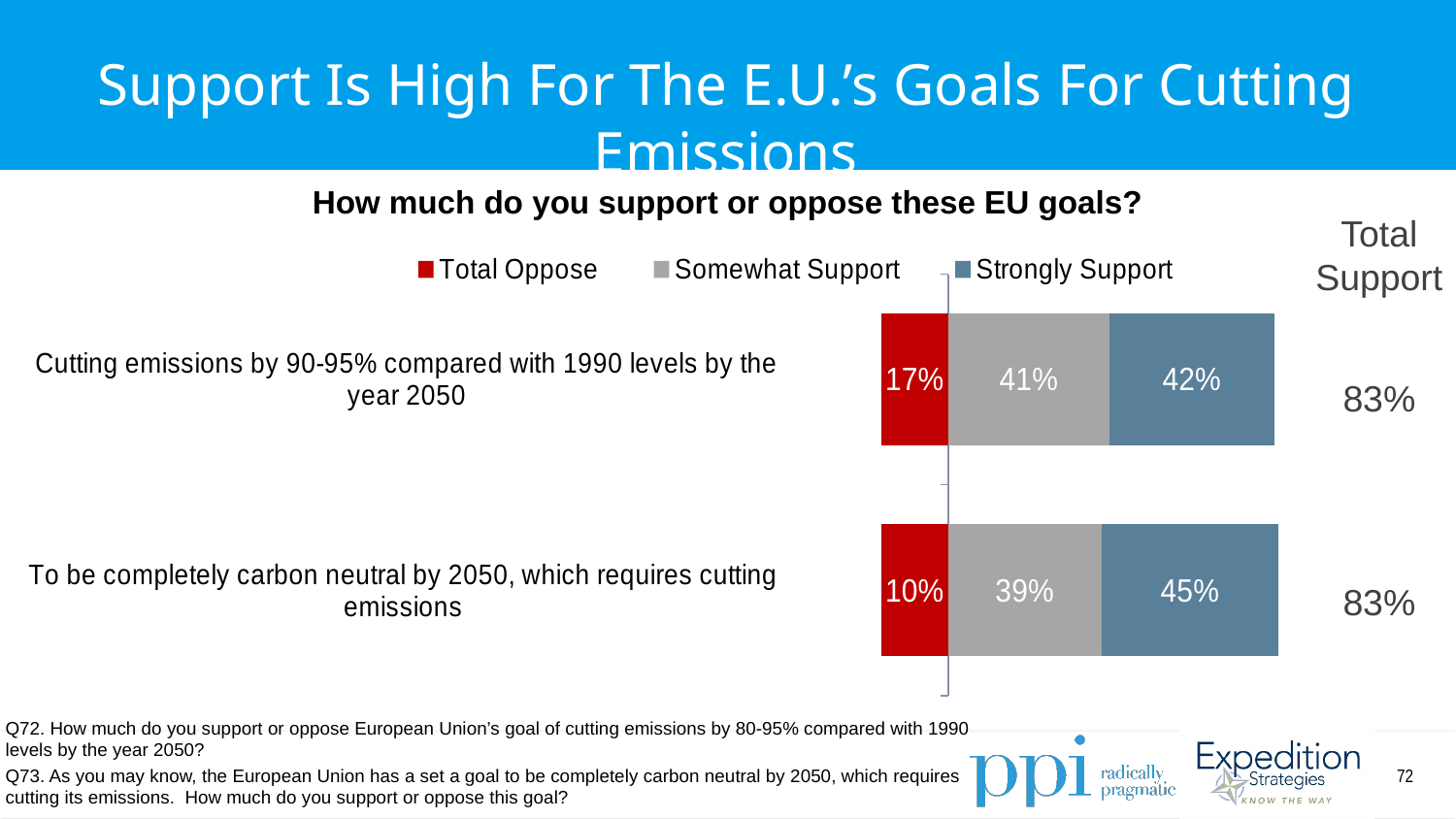
What percentage of respondents strongly support cutting emissions by 90-95% compared with 1990 levels by the year 2050? 42% How many series does the legend list? 3 Which colour represents Total Oppose in the chart? Red How many EU goals are shown in the chart? 2 What type of chart is shown on the slide? Stacked bar chart What percentage of respondents somewhat support the goal to be completely carbon neutral by 2050? 39% Is the Somewhat Support value larger for the 90-95% emissions cut goal or the carbon neutral by 2050 goal? The 90-95% emissions cut goal What is the difference in Total Oppose between the 90-95% emissions cut goal and the carbon neutral by 2050 goal? 7 percentage points Which goal has the higher Strongly Support percentage? To be completely carbon neutral by 2050, which requires cutting emissions What is the Total Oppose value for the goal to be completely carbon neutral by 2050? 10% Which goal has the higher Total Oppose percentage? Cutting emissions by 90-95% compared with 1990 levels by the year 2050 What is the Total Support figure shown for cutting emissions by 90-95% compared with 1990 levels by 2050? 83%